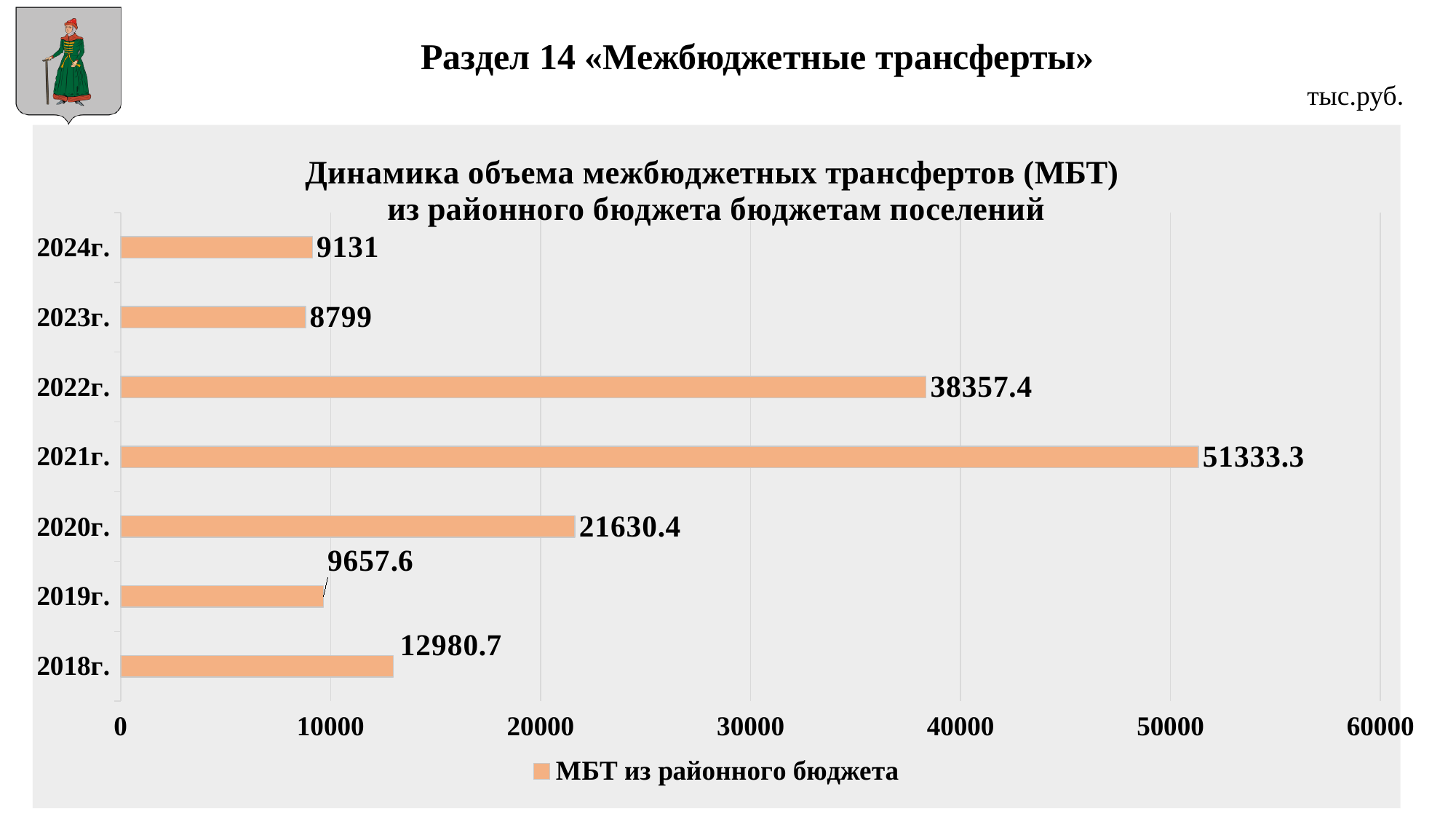
Is the value for 2022г. greater or less than 40000? less What is the value for 2023г.? 8799 Which is larger, the value for 2020г. or the value for 2018г.? 2020г. What kind of chart is shown on the slide? bar chart What is the value for 2018г.? 12980.7 Which year has the lowest value? 2023г. What is the value for 2021г.? 51333.3 Which year has the highest value? 2021г. How many years are shown on the chart? 7 What is the legend entry for the series shown? МБТ из районного бюджета What is the difference between the values for 2024г. and 2023г.? 332 What is the difference between the values for 2021г. and 2022г.? 12975.9